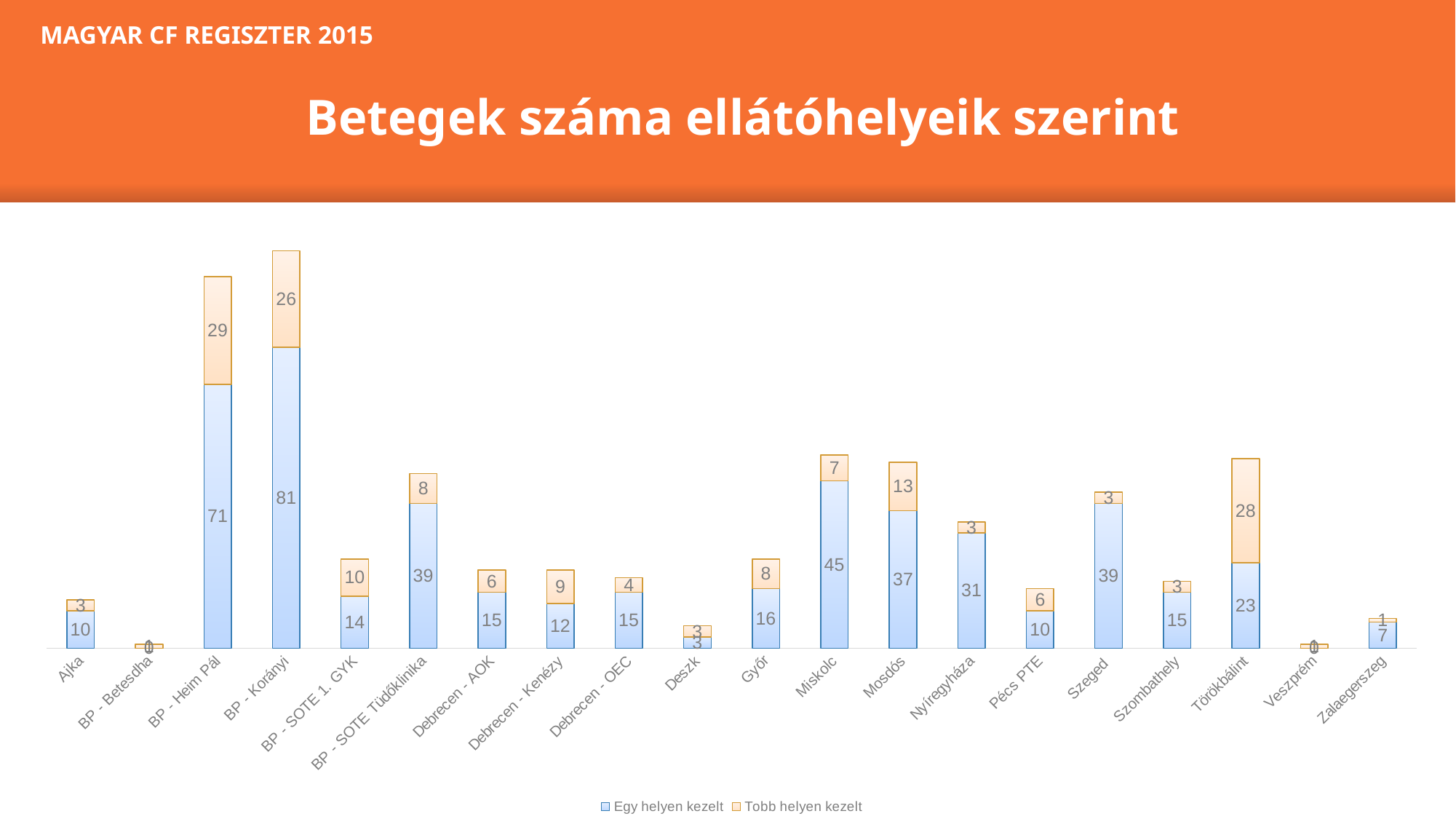
How many categories are shown on the x axis? 20 What type of chart is shown on the slide? Stacked bar chart What is the 'Egy helyen kezelt' value for Mosdós? 37 Which category has the highest 'Tobb helyen kezelt' value? BP - Heim Pál What is the difference between the 'Egy helyen kezelt' values for Szeged and Nyíregyháza? 8 What is the total of the stacked bar for BP - Heim Pál? 100 What is the 'Tobb helyen kezelt' value for Törökbálint? 28 Which is larger: the 'Egy helyen kezelt' value for Győr or for Debrecen - Kenézy? Győr Which category has the highest 'Egy helyen kezelt' value? BP - Korányi How many series does the legend list? 2 What is the 'Egy helyen kezelt' value for BP - Korányi? 81 What is the total of the stacked bar for Miskolc? 52